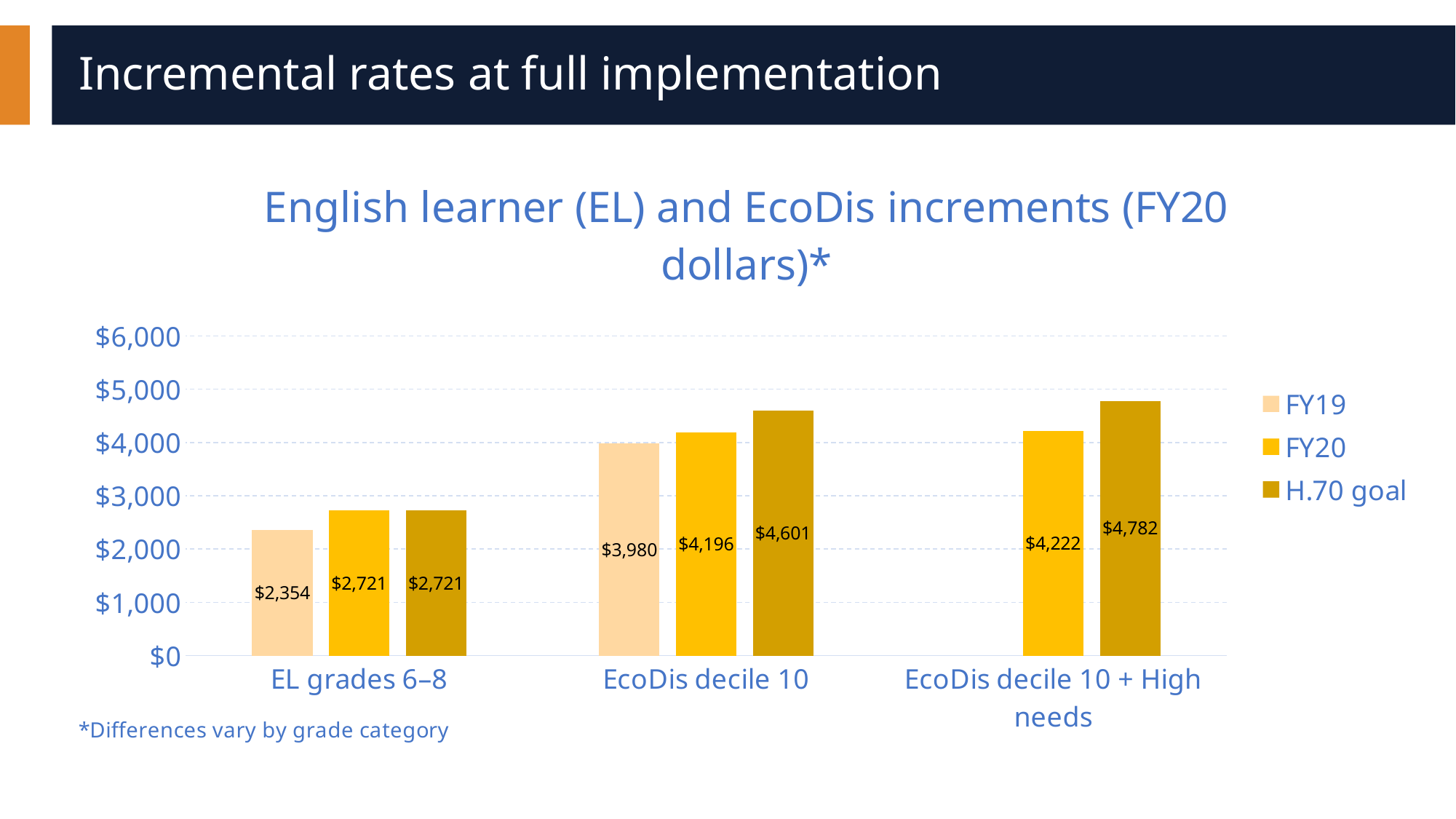
How many categories are shown on the x axis? 3 What is the H.70 goal value for EcoDis decile 10? $4,601 Which category has the highest H.70 goal value? EcoDis decile 10 + High needs Which is larger for EcoDis decile 10: the FY19 value or the H.70 goal value? H.70 goal What is the FY19 value for EL grades 6–8? $2,354 What is the FY20 value for EcoDis decile 10 + High needs? $4,222 How many series does the legend list? 3 What is the difference between the FY20 and FY19 values for EL grades 6–8? $367 What kind of chart is shown on the slide? bar chart Which category has the lowest FY20 value? EL grades 6–8 Is the FY19 value for EcoDis decile 10 greater or less than $3,000? greater What is the difference between the H.70 goal and FY20 values for EcoDis decile 10 + High needs? $560